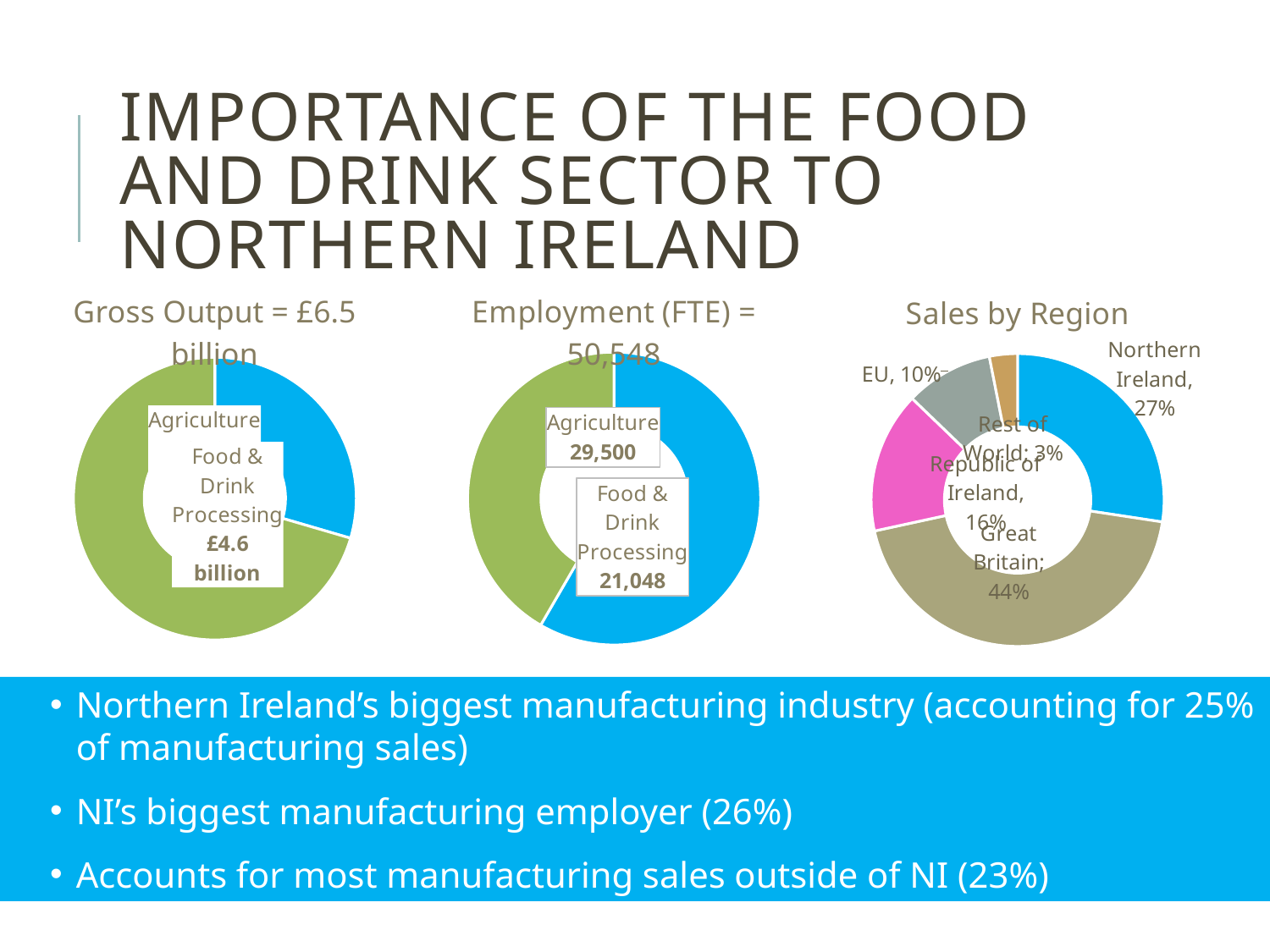
How many regions are shown in the 'Sales by Region' chart? 5 In the 'Employment (FTE) = 50,548' chart, what is the value for Agriculture? 29,500 In the 'Employment (FTE) = 50,548' chart, what is the value for Food & Drink Processing? 21,048 In the 'Employment (FTE) = 50,548' chart, what is the difference between the Agriculture value and the Food & Drink Processing value? 8,452 In the 'Sales by Region' chart, which region has the largest share of sales? Great Britain In the 'Sales by Region' chart, what share of sales is Great Britain? 44% In the 'Sales by Region' chart, what is the share for the EU? 10% In the 'Sales by Region' chart, which is larger: Republic of Ireland or EU? Republic of Ireland In the 'Gross Output = £6.5 billion' chart, what is the value for Food & Drink Processing? £4.6 billion What kind of chart is the 'Sales by Region' chart? doughnut chart In the 'Sales by Region' chart, what is the difference between the Great Britain share and the Northern Ireland share? 17% In the 'Sales by Region' chart, which region has the smallest share of sales? Rest of World